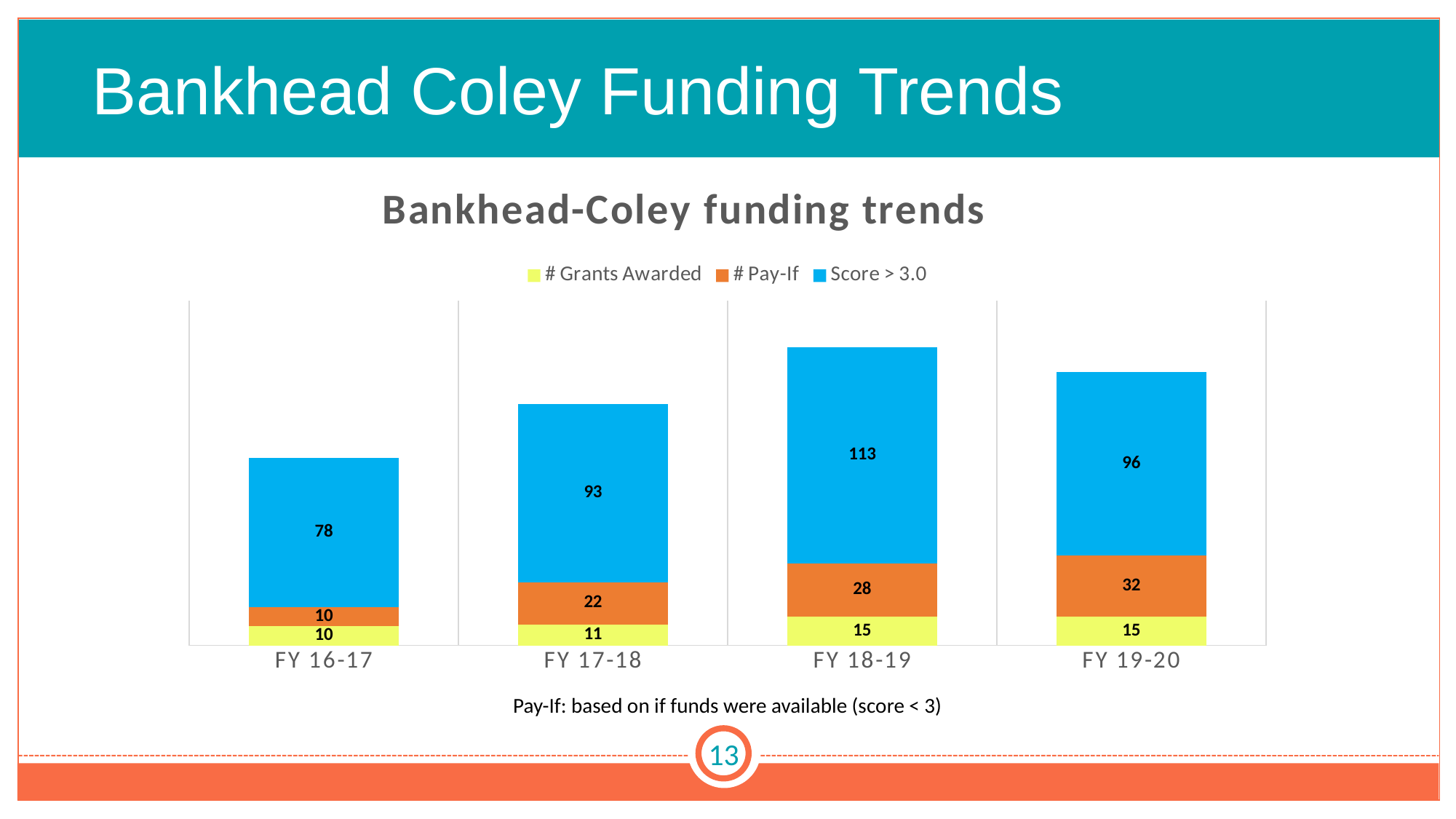
How many fiscal years are shown on the x axis? 4 What is the value of Score > 3.0 for FY 18-19? 113 What is the difference between the Score > 3.0 values for FY 18-19 and FY 16-17? 35 What is the total of the stacked bar for FY 17-18? 126 What kind of chart is shown? Stacked bar chart What is the value of # Grants Awarded for FY 19-20? 15 What is the title of the chart? Bankhead-Coley funding trends Which is larger, # Pay-If for FY 19-20 or # Pay-If for FY 18-19? FY 19-20 What is the value of # Pay-If for FY 17-18? 22 Which fiscal year has the highest Score > 3.0 value? FY 18-19 Which fiscal year has the lowest # Pay-If value? FY 16-17 How many series does the legend list? 3